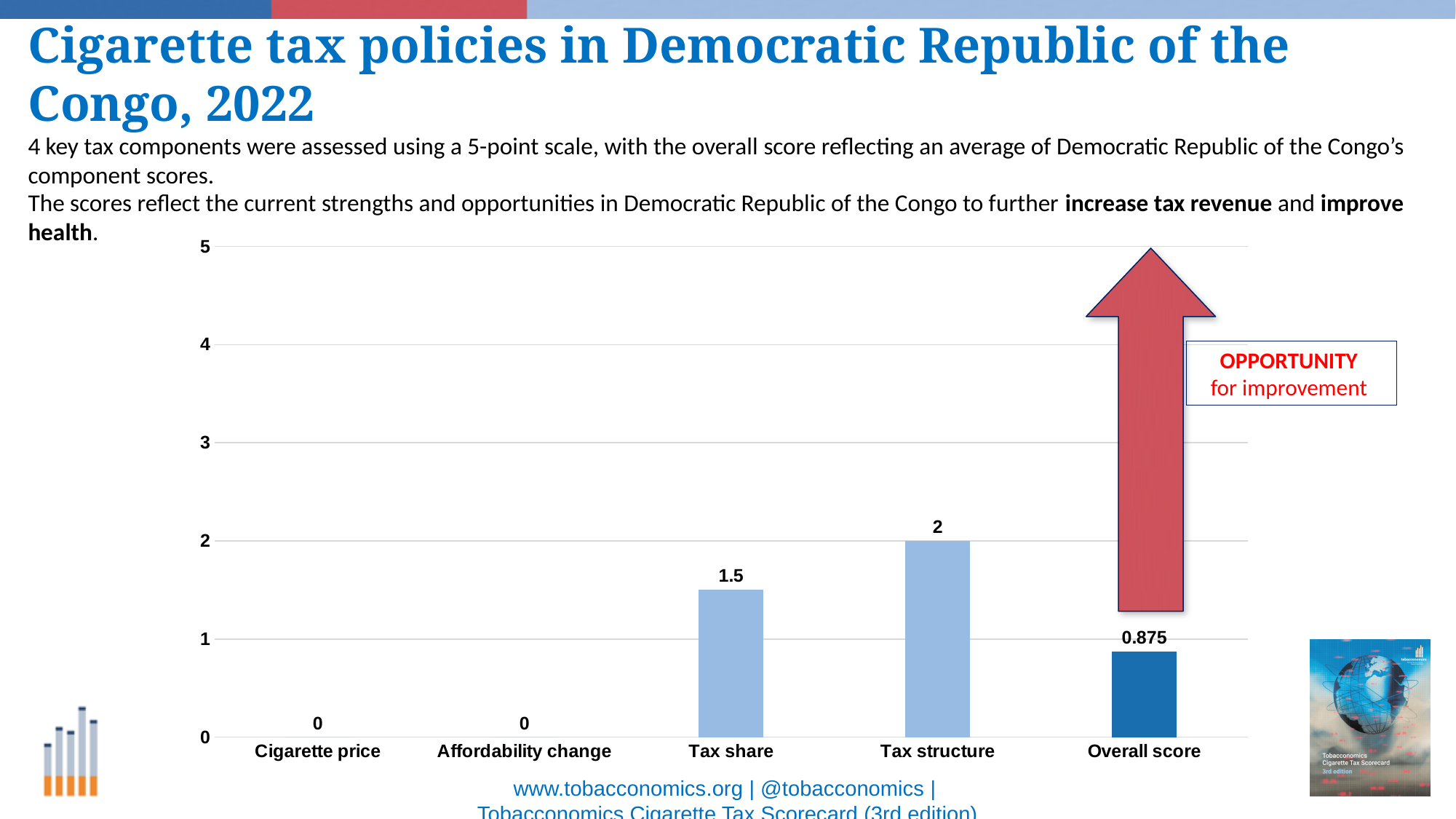
Is the value for Overall score greater or less than 1? less How many categories are shown on the x axis? 5 What is the Overall score? 0.875 What is the difference between Tax structure and Tax share? 0.5 What is the value for Cigarette price? 0 Which is larger, Tax share or Overall score? Tax share What is the maximum value shown on the y axis? 5 What is the value for Tax structure? 2 Which category has the highest value? Tax structure What is the value for Tax share? 1.5 What kind of chart is shown? bar chart What text appears in the box next to the red arrow? OPPORTUNITY for improvement